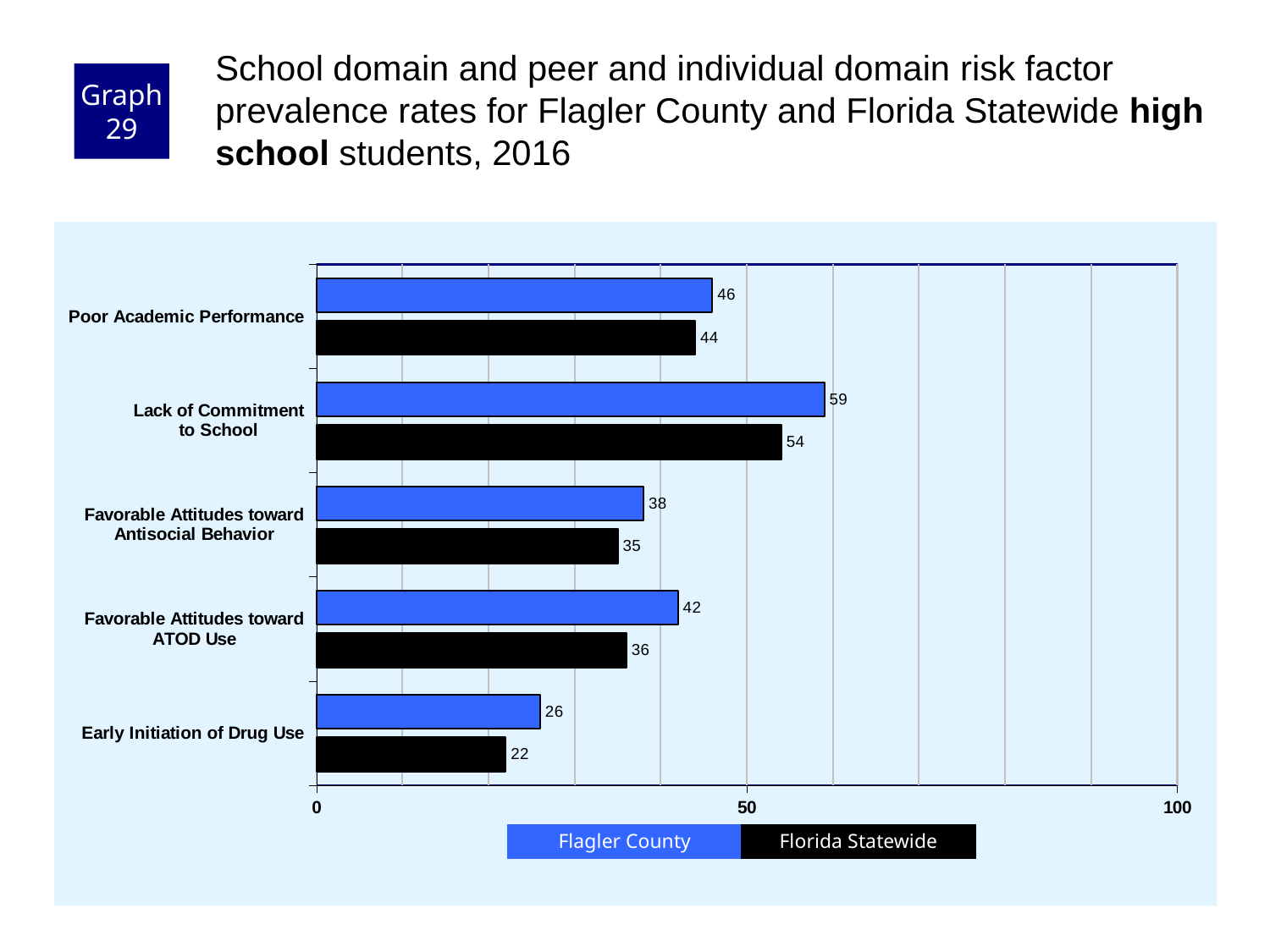
How many risk factor categories are shown on the chart? 5 What is the Florida Statewide value for Favorable Attitudes toward ATOD Use? 36 What is the Flagler County value for Lack of Commitment to School? 59 Which colour represents Florida Statewide in the chart? Black Which risk factor has the highest Flagler County value? Lack of Commitment to School Which is larger for Poor Academic Performance: the Flagler County value or the Florida Statewide value? Flagler County How many series does the legend list? 2 What kind of chart is shown on the slide? Bar chart What is the difference between the Flagler County and Florida Statewide values for Favorable Attitudes toward ATOD Use? 6 What is the Florida Statewide value for Early Initiation of Drug Use? 22 Is the Florida Statewide value for Lack of Commitment to School greater or less than 50? greater Which risk factor has the lowest Florida Statewide value? Early Initiation of Drug Use